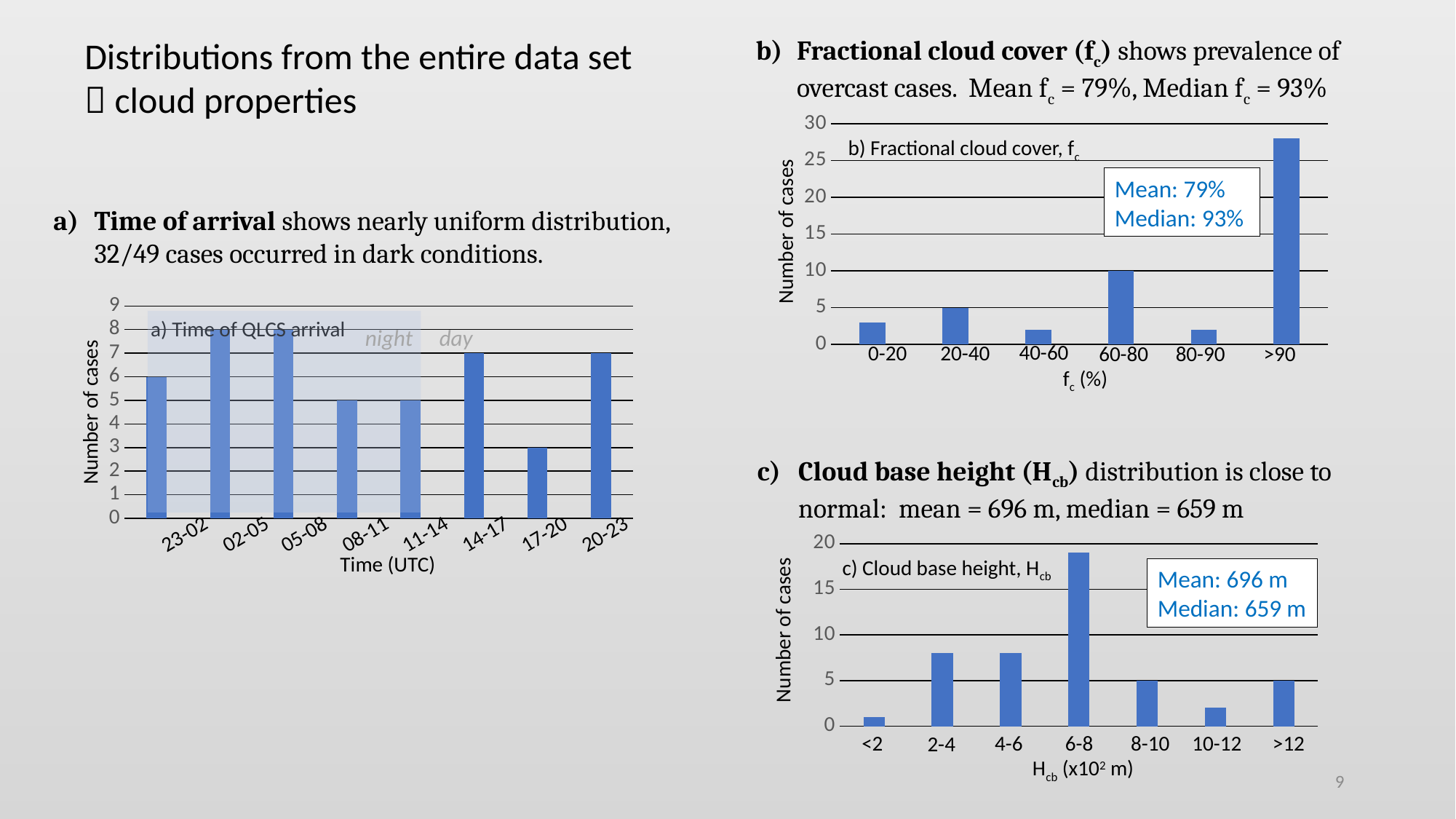
In the chart titled 'a) Time of QLCS arrival', what is the difference in number of cases between the 02-05 bin and the 17-20 bin? 5 In the chart titled 'b) Fractional cloud cover', what mean value is shown in the annotation box? 79% In the chart titled 'b) Fractional cloud cover', which f_c bin has the most cases? >90 In the chart titled 'a) Time of QLCS arrival', how many cases are in the 23-02 time bin? 6 In the chart titled 'a) Time of QLCS arrival', which time bin has the fewest cases? 17-20 In the chart titled 'b) Fractional cloud cover', how many cases are in the 60-80 bin? 10 In the chart titled 'a) Time of QLCS arrival', how many time bins are shown on the x axis? 8 What kind of chart is the chart titled 'c) Cloud base height'? bar chart In the chart titled 'b) Fractional cloud cover', is the number of cases for the >90 bin greater or less than 25? greater In the chart titled 'c) Cloud base height', which H_cb bin has the most cases? 6-8 In the chart titled 'c) Cloud base height', is the number of cases for the 6-8 bin greater or less than 15? greater In the chart titled 'a) Time of QLCS arrival', how many cases are in the 17-20 time bin? 3